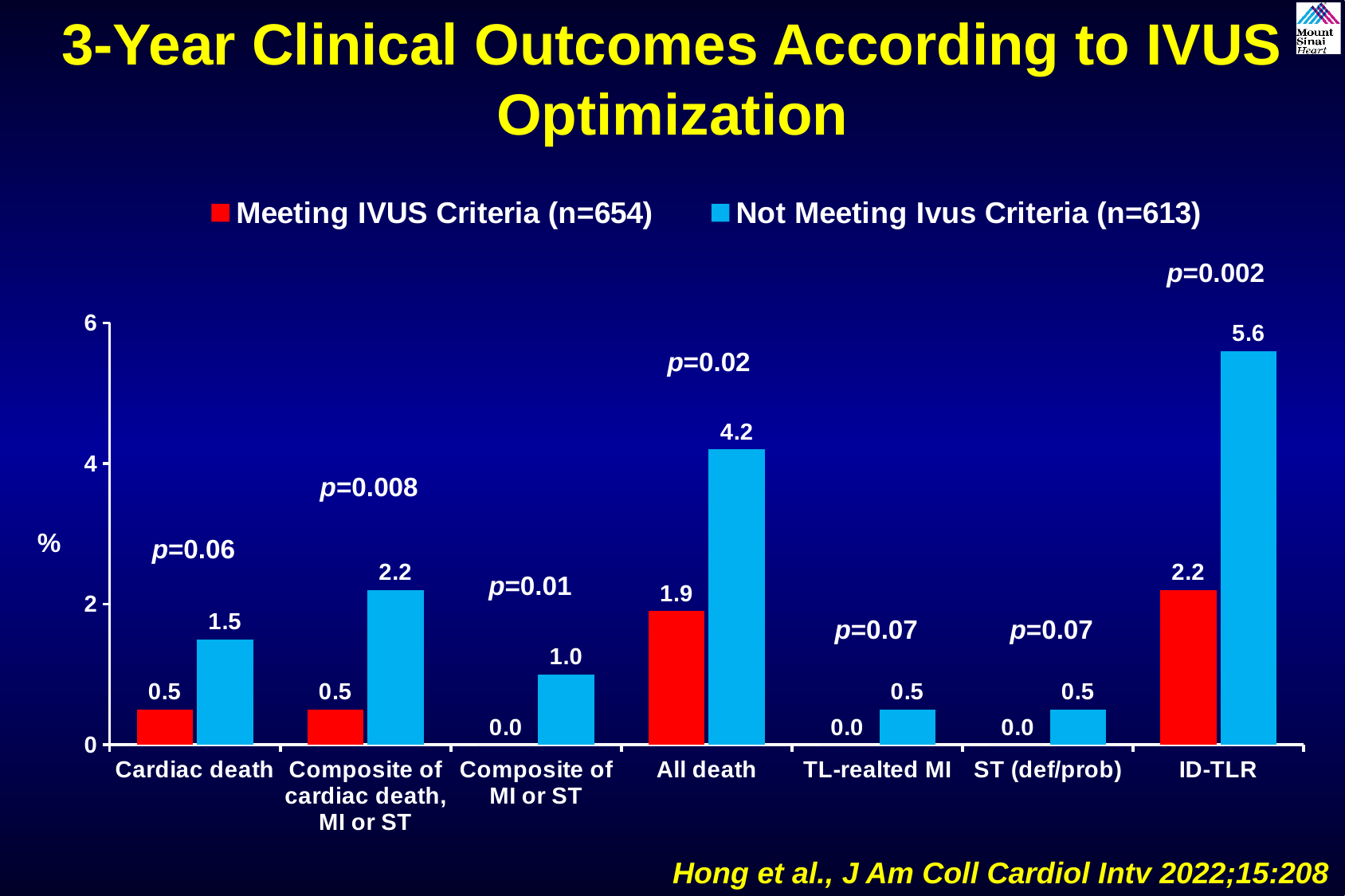
What kind of chart is shown on the slide? Bar chart What is the difference between the Not Meeting Ivus Criteria and Meeting IVUS Criteria values for ID-TLR? 3.4 What is the value for Meeting IVUS Criteria for ID-TLR? 2.2 How many categories are shown on the x axis? 7 What is the value for Not Meeting Ivus Criteria for Cardiac death? 1.5 How many series does the legend list? 2 Which category has the highest value for Meeting IVUS Criteria? ID-TLR What p-value is shown above the ID-TLR bars? p=0.002 What is the value for Not Meeting Ivus Criteria for All death? 4.2 Which is larger for Composite of MI or ST: Meeting IVUS Criteria or Not Meeting Ivus Criteria? Not Meeting Ivus Criteria What is the difference between the Not Meeting Ivus Criteria and Meeting IVUS Criteria values for All death? 2.3 Which category has the highest value for Not Meeting Ivus Criteria? ID-TLR